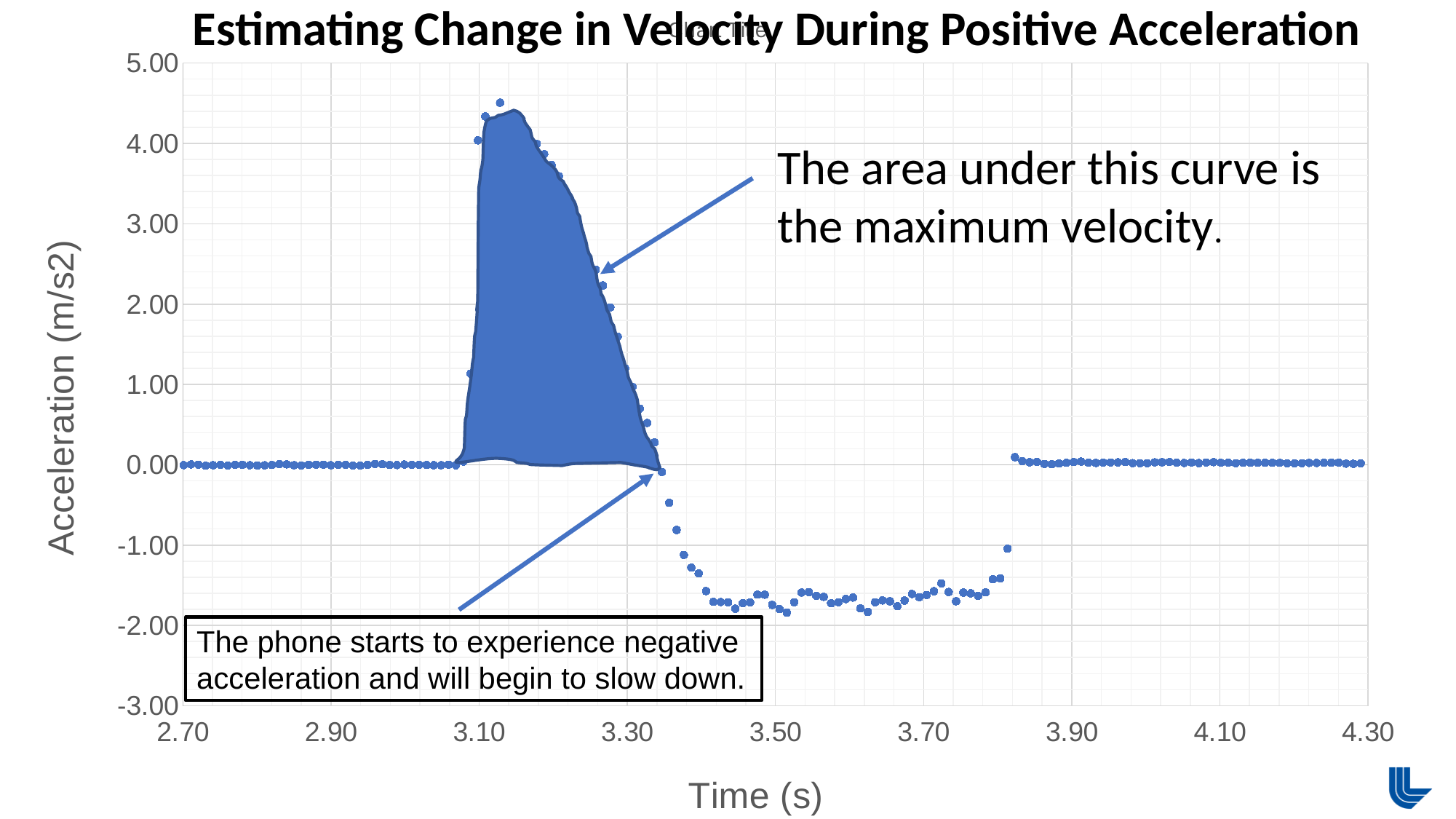
Is the peak acceleration value in the chart greater or less than 4.00? greater What is the label of the vertical axis? Acceleration (m/s2) Is the lowest acceleration value in the chart greater or less than -1.00? less Between time 3.20 and 3.30, does the acceleration rise or fall? fall Is the acceleration at time 2.90 greater or less than 1.00? less What kind of chart is shown on the slide? scatter chart What is the label of the horizontal axis? Time (s) What is the highest tick value shown on the vertical axis? 5.00 Is the acceleration at time 3.10 larger or smaller than the acceleration at time 3.60? larger